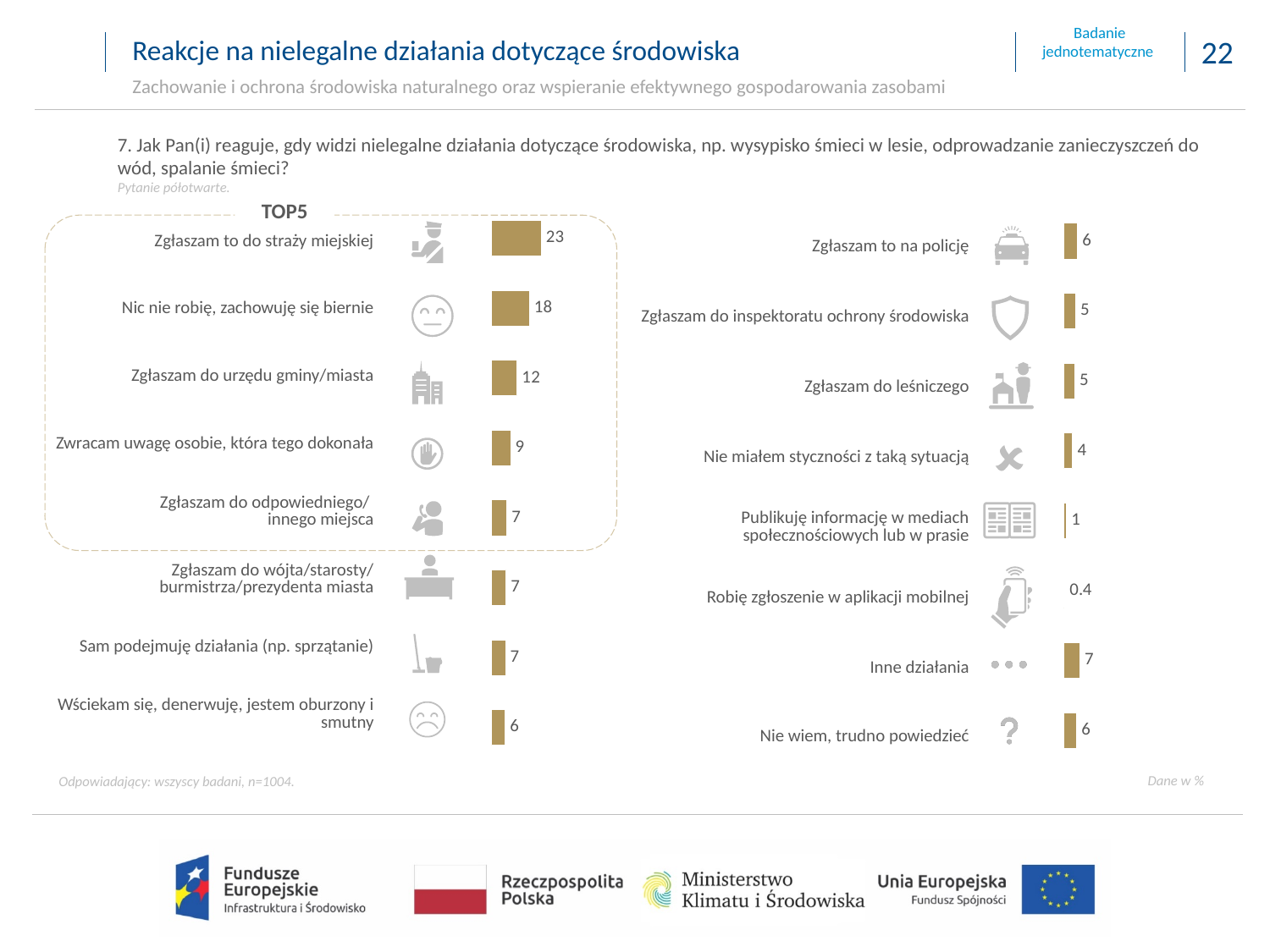
On the left chart, what is the value for "Nic nie robię, zachowuję się biernie"? 18 On the left chart, which is larger: "Zgłaszam do urzędu gminy/miasta" or "Zwracam uwagę osobie, która tego dokonała"? Zgłaszam do urzędu gminy/miasta On the left chart, what is the difference between "Zgłaszam to do straży miejskiej" and "Nic nie robię, zachowuję się biernie"? 5 What kind of chart is used on the slide? Bar chart On the left chart, what is the value for "Zgłaszam to do straży miejskiej"? 23 On the right chart, which category has the lowest value? Robię zgłoszenie w aplikacji mobilnej On the right chart, what is the value for "Robię zgłoszenie w aplikacji mobilnej"? 0.4 On the right chart, what is the value for "Inne działania"? 7 On the left chart, which category has the highest value? Zgłaszam to do straży miejskiej How many categories are shown on the left chart? 8 On the left chart, how many categories are enclosed in the dashed "TOP5" box? 5 On the right chart, which is larger: "Zgłaszam to na policję" or "Nie miałem styczności z taką sytuacją"? Zgłaszam to na policję